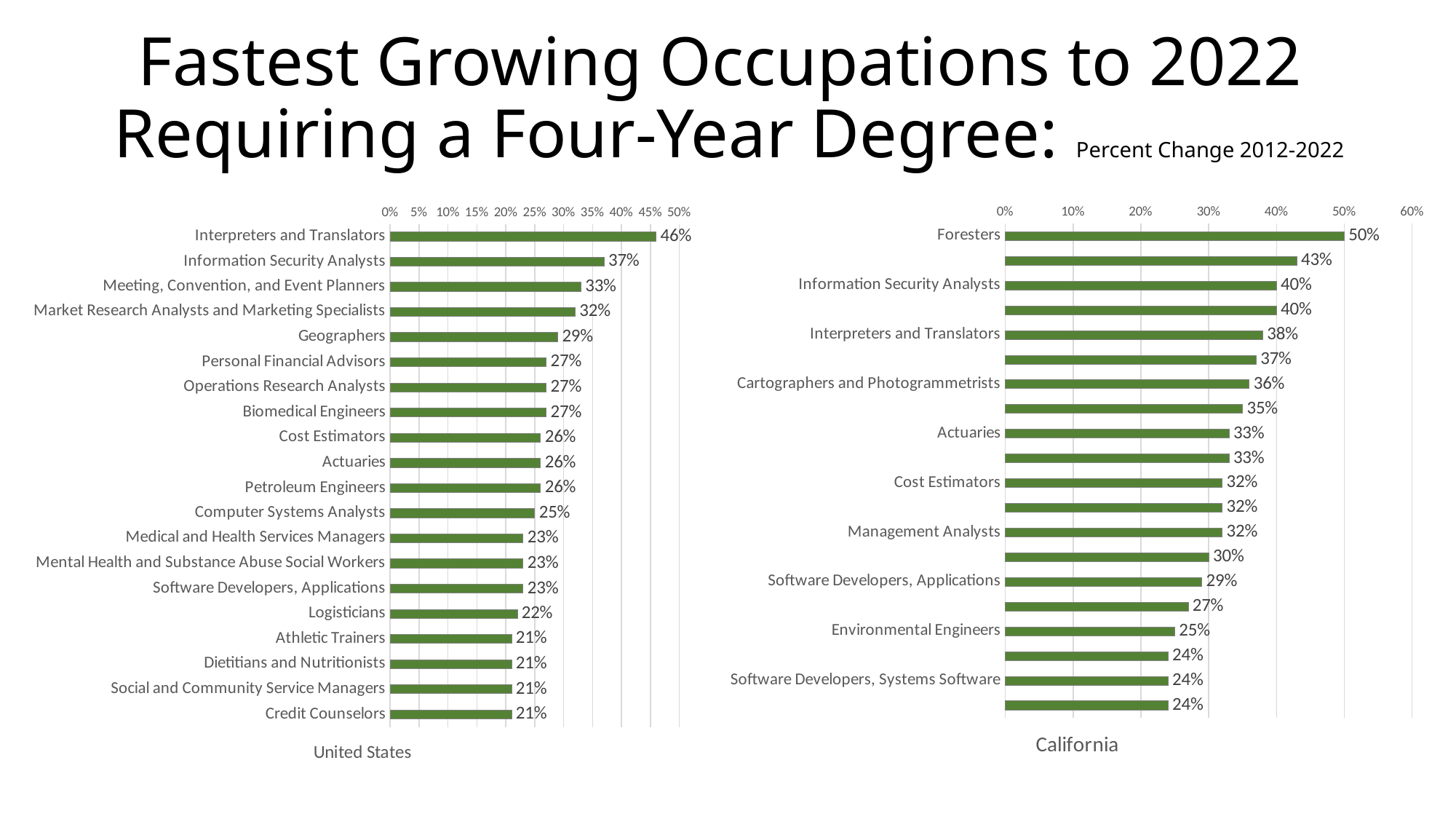
In the United States chart, what is the value for Geographers? 29% In the United States chart, what is the value for Interpreters and Translators? 46% In the California chart, what is the value for Foresters? 50% In the United States chart, what is the difference between Interpreters and Translators and Information Security Analysts? 9% How many bars are plotted in the United States chart? 20 In the California chart, what is the difference between Foresters and Environmental Engineers? 25% In the United States chart, which is larger: Logisticians or Computer Systems Analysts? Computer Systems Analysts In the California chart, which is larger: Actuaries or Software Developers, Applications? Actuaries In the California chart, which occupation has the highest value? Foresters In the California chart, what is the value for Cartographers and Photogrammetrists? 36% In the United States chart, which occupation has the highest value? Interpreters and Translators What type of chart is the California chart? Bar chart